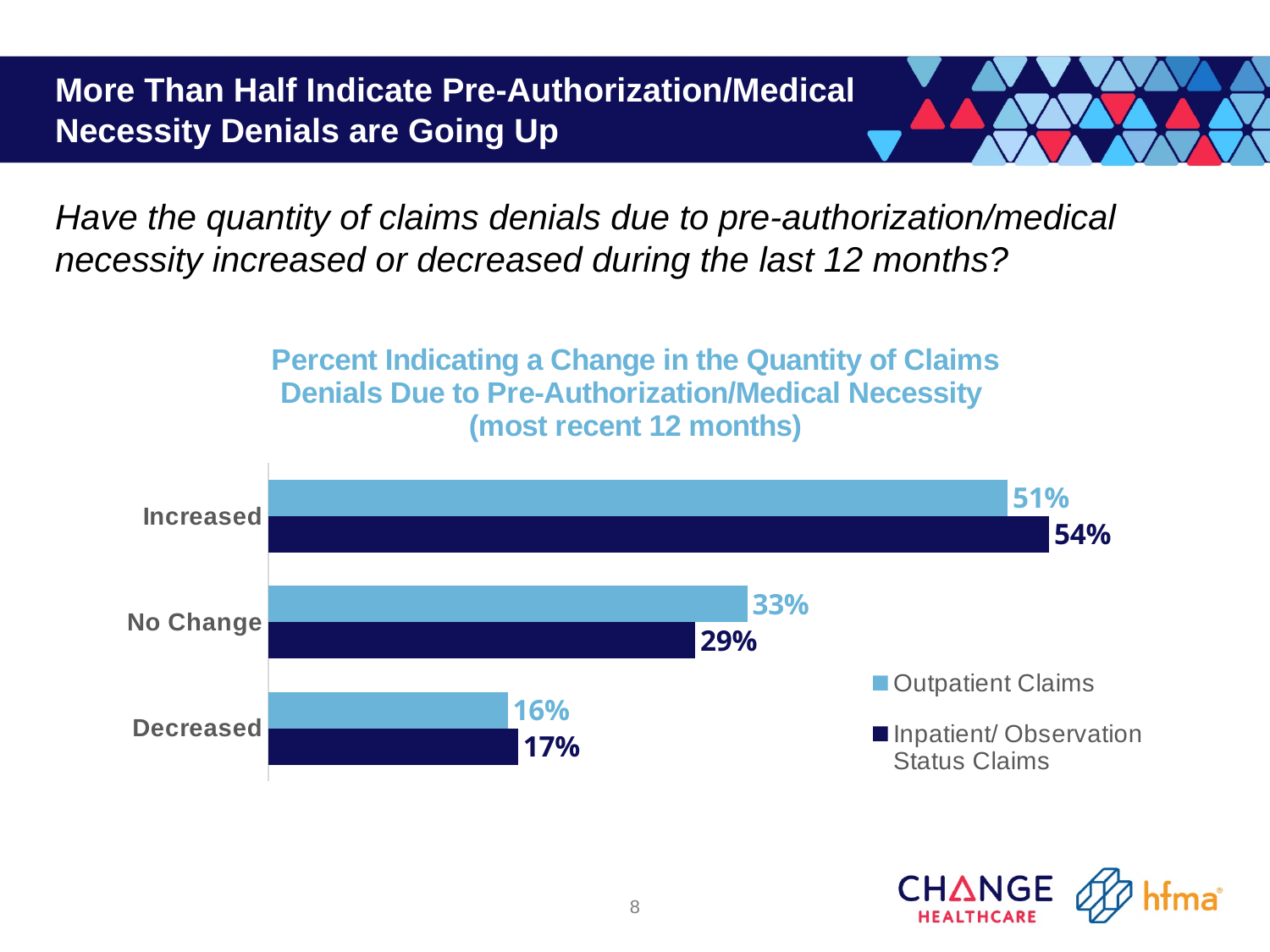
What is the value for No Change for Outpatient Claims? 33% What kind of chart is shown on the slide? Bar chart How many series does the legend list? 2 What percentage of Outpatient Claims respondents indicated denials Increased? 51% Which category has the highest value for Inpatient/ Observation Status Claims? Increased Which series is shown in dark navy blue in the legend? Inpatient/ Observation Status Claims What is the difference between the Outpatient Claims and Inpatient/ Observation Status Claims values for No Change? 4% How many categories are shown on the chart? 3 For the Increased category, which series has the larger value: Outpatient Claims or Inpatient/ Observation Status Claims? Inpatient/ Observation Status Claims What is the value for Decreased for Inpatient/ Observation Status Claims? 17% Which category has the lowest value for Outpatient Claims? Decreased What percentage of Inpatient/ Observation Status Claims respondents indicated denials Increased? 54%